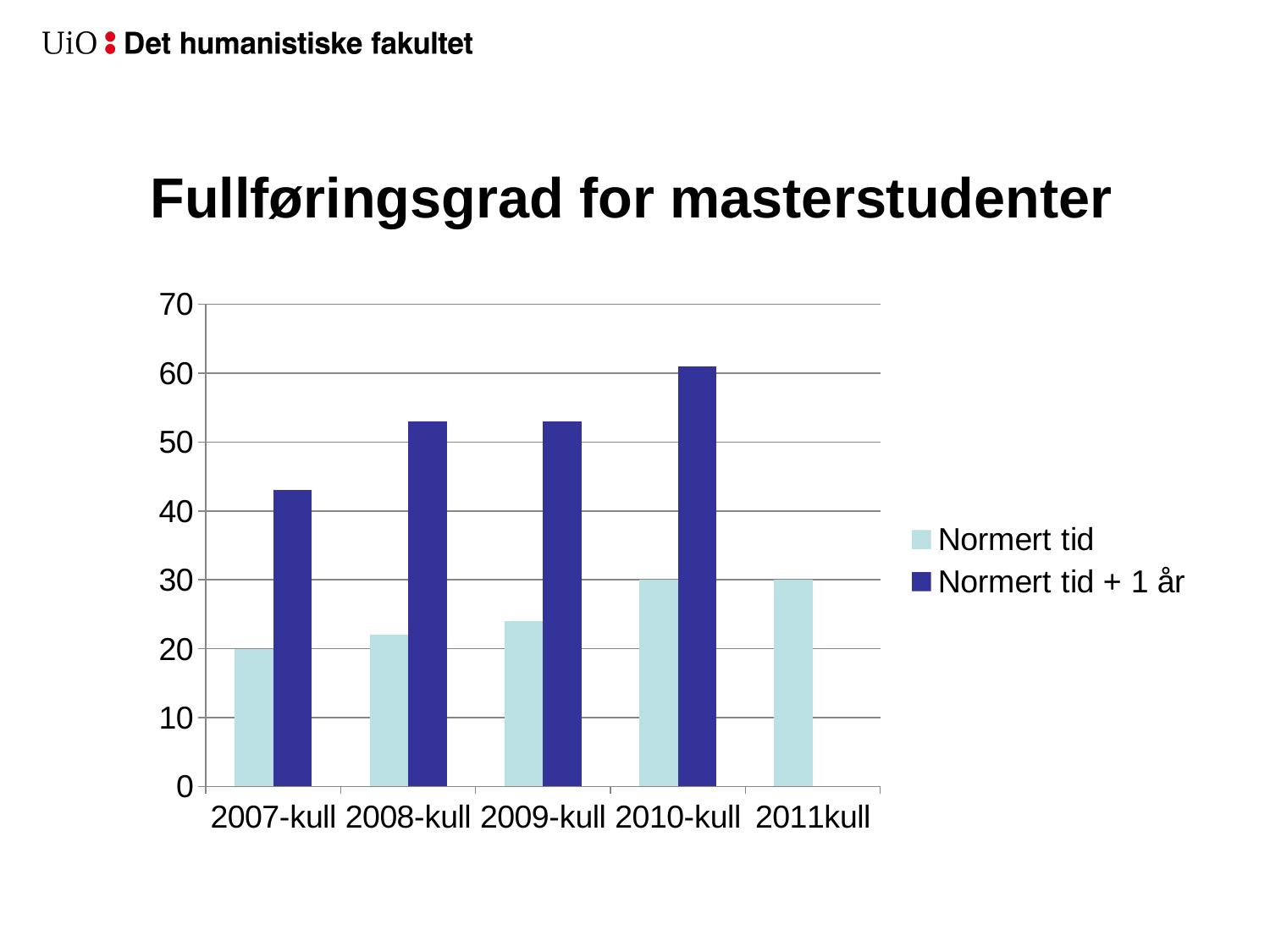
What kind of chart is shown on the slide? bar chart Which cohort has the highest value for Normert tid + 1 år? 2010-kull How many series does the legend list? 2 Is the value for Normert tid for 2009-kull greater or less than 20? greater How many cohort categories are shown on the x axis? 5 Does the value for Normert tid + 1 år generally rise or fall from 2007-kull to 2010-kull? rise Which cohort has no bar for Normert tid + 1 år? 2011kull What is the title of the chart? Fullføringsgrad for masterstudenter Which is larger: Normert tid + 1 år for 2010-kull or for 2008-kull? 2010-kull Is the value for Normert tid + 1 år for 2007-kull greater or less than 50? less Which cohort has the lowest value for Normert tid + 1 år? 2007-kull